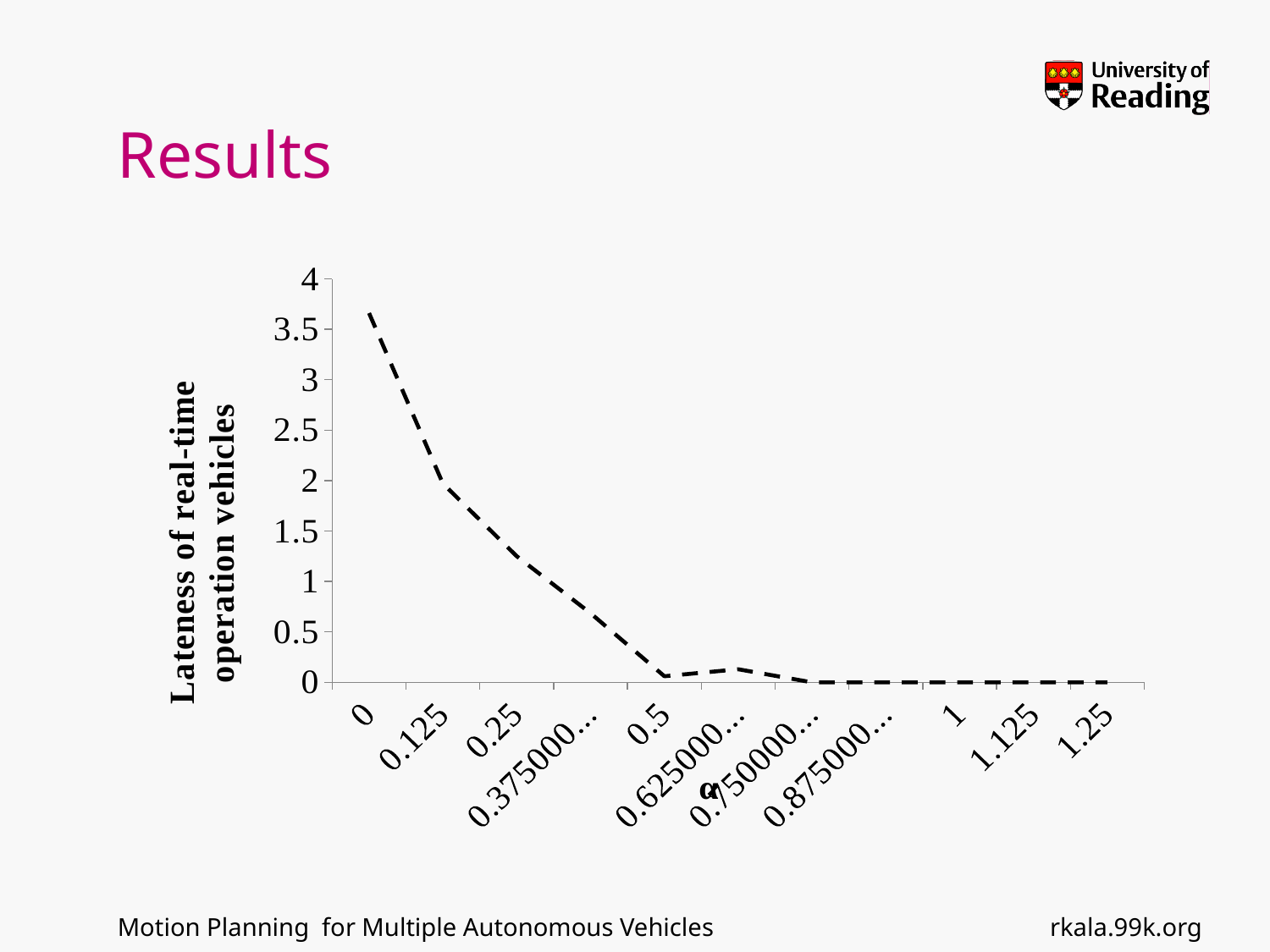
What kind of chart is shown on the slide? line chart Is the lateness at α = 0.5 greater or less than 0.5? less At which value of α is the lateness highest? 0 Is the lateness at α = 0 greater or less than 3? greater Which has the larger lateness, α = 0 or α = 0.5? α = 0 What is the title of the y axis? Lateness of real-time operation vehicles How many x-axis categories are plotted? 11 Is the lateness at α = 1 greater or less than 0.5? less What is the label of the x axis? α Does the lateness rise or fall as α increases from 0 to 0.5? fall